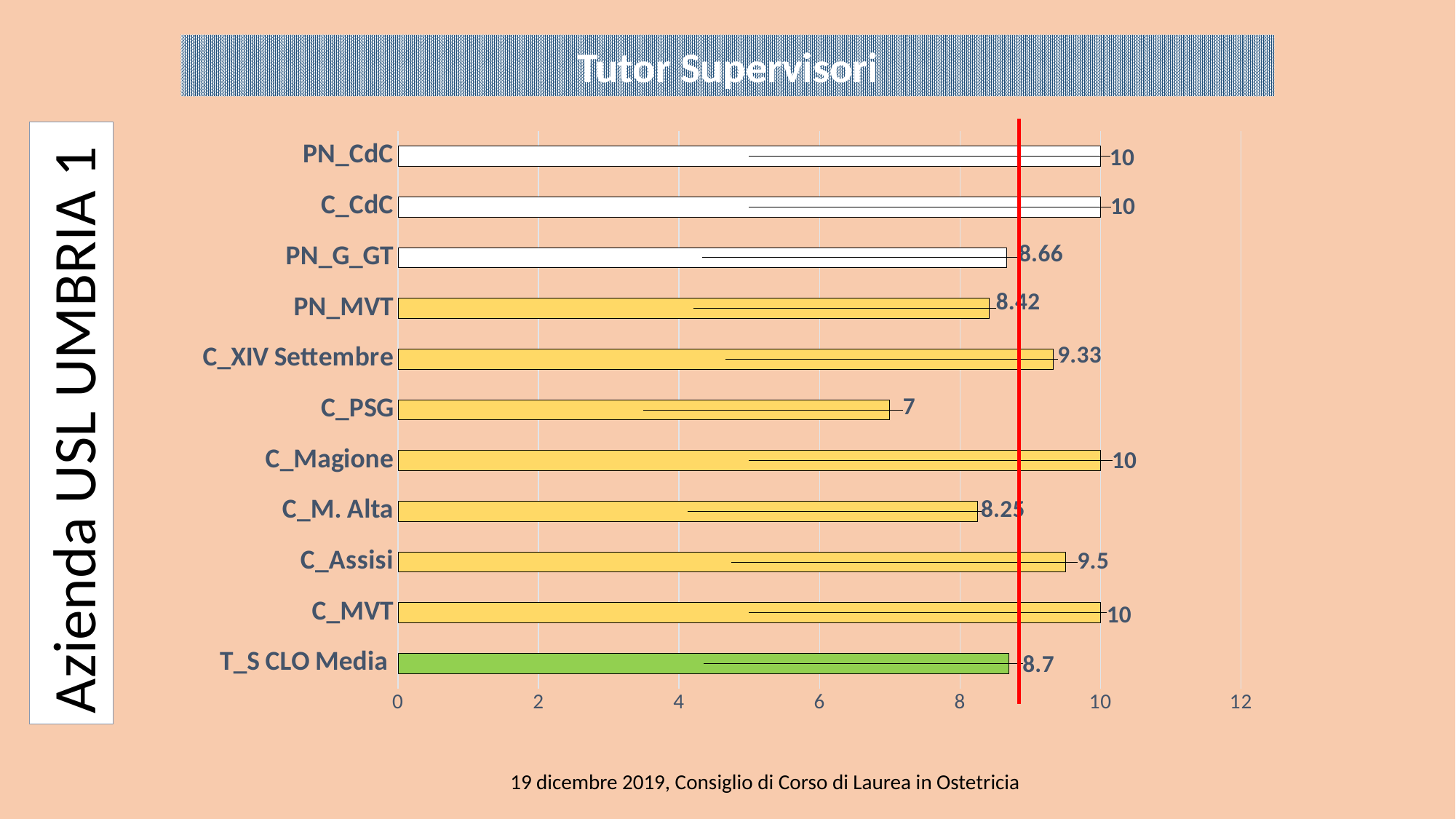
Is the value for C_PSG greater or less than 8? less What is the value for T_S CLO Media? 8.7 What is the title of the chart? Tutor Supervisori What is the value for C_PSG? 7 What is the value for C_XIV Settembre? 9.33 Which is larger, the value for PN_MVT or the value for C_XIV Settembre? C_XIV Settembre How many categories are shown in the chart? 11 What is the difference between the values for C_Assisi and C_M. Alta? 1.25 What kind of chart is shown on the slide? bar chart What is the value for PN_G_GT? 8.66 Which category has the lowest value? C_PSG What is the difference between the values for C_Magione and C_PSG? 3